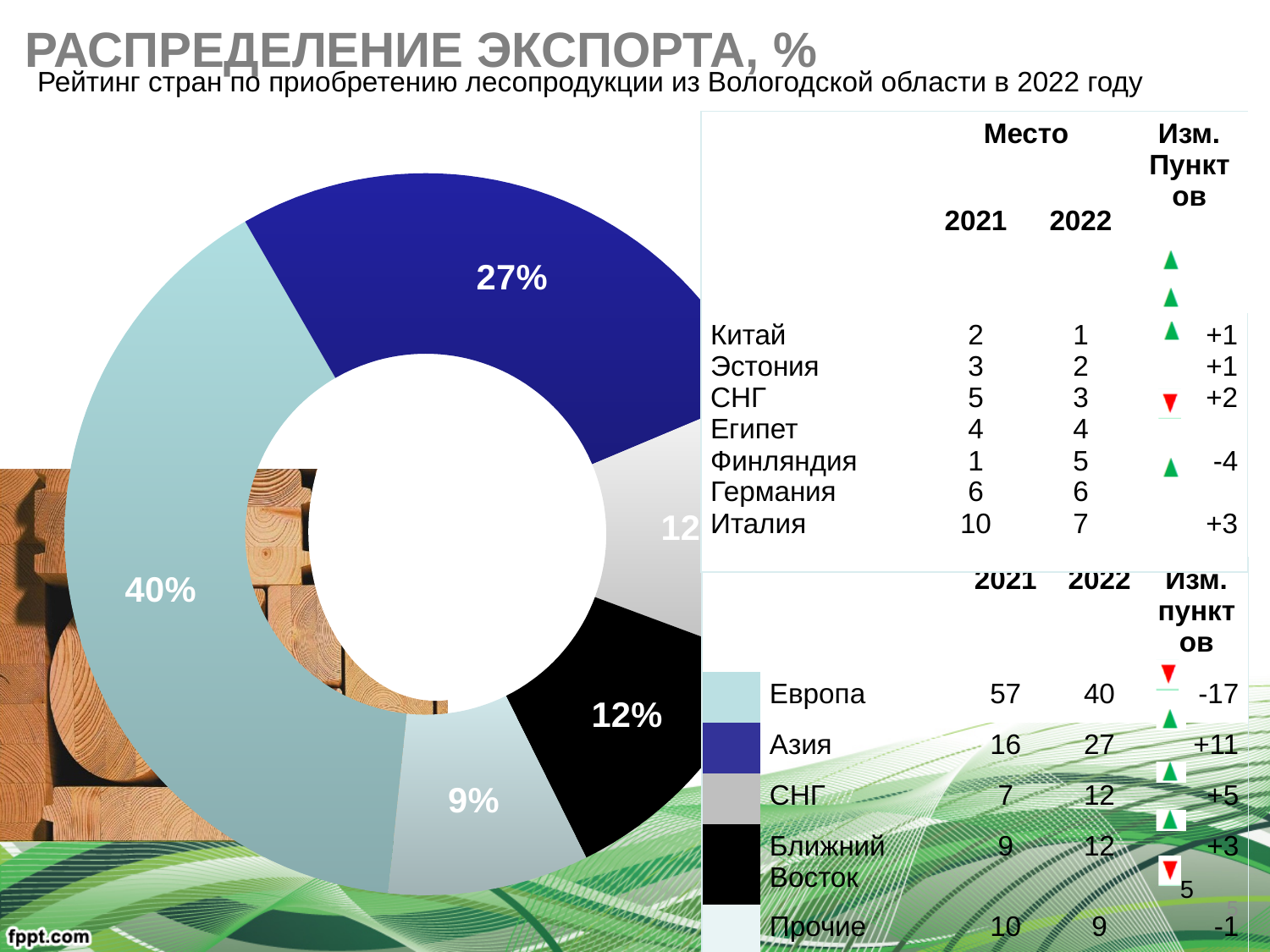
What is the title of the chart on the slide? РАСПРЕДЕЛЕНИЕ ЭКСПОРТА, % What share of exports does Европа account for in the doughnut chart? 40% What share of exports does Прочие account for in the doughnut chart? 9% Which slice is larger in the doughnut chart, Азия or Ближний Восток? Азия How many slices does the doughnut chart have? 5 What kind of chart is shown on the slide? Doughnut (pie) chart What colour is the Азия slice in the doughnut chart? Dark blue Which region has the smallest slice in the doughnut chart? Прочие Which region has the largest slice in the doughnut chart? Европа How many percentage points larger is the Европа slice than the Азия slice? 13 What share of exports does Ближний Восток account for in the doughnut chart? 12% What share of exports does Азия account for in the doughnut chart? 27%